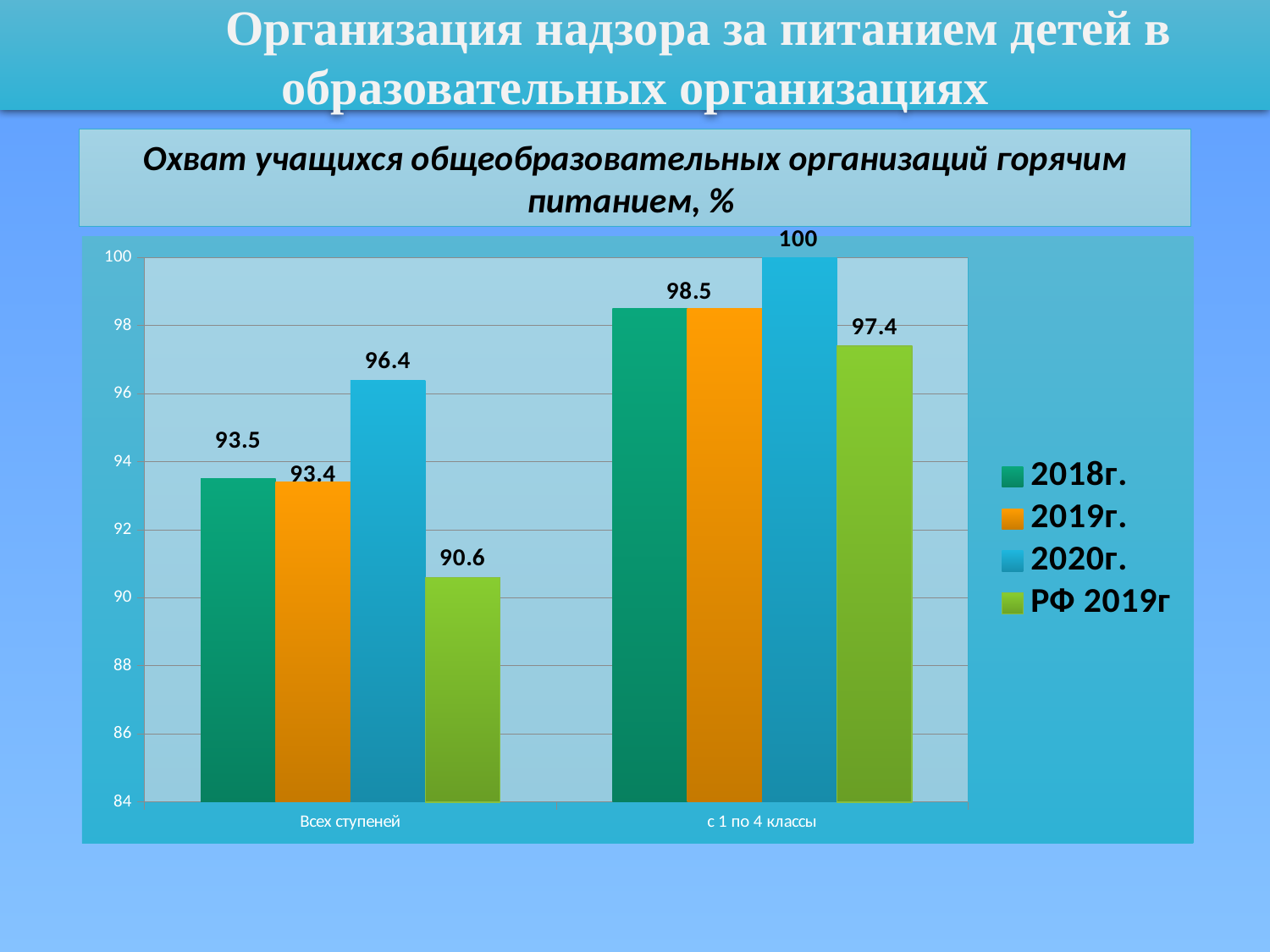
How many categories are shown on the x axis? 2 What type of chart is shown on the slide? bar chart Which series has the highest value in the category "с 1 по 4 классы"? 2020г. How many series does the legend list? 4 What is the value for РФ 2019г in the category "Всех ступеней"? 90.6 What is the value for 2020г. in the category "с 1 по 4 классы"? 100 Is the value for 2019г. in the category "с 1 по 4 классы" greater or less than 96? greater Which is larger in the category "с 1 по 4 классы": the value for 2018г. or the value for РФ 2019г? 2018г. What is the difference between the 2020г. value and the РФ 2019г value in the category "Всех ступеней"? 5.8 What is the value for 2018г. in the category "с 1 по 4 классы"? 98.5 Which series has the lowest value in the category "Всех ступеней"? РФ 2019г What is the value for 2020г. in the category "Всех ступеней"? 96.4